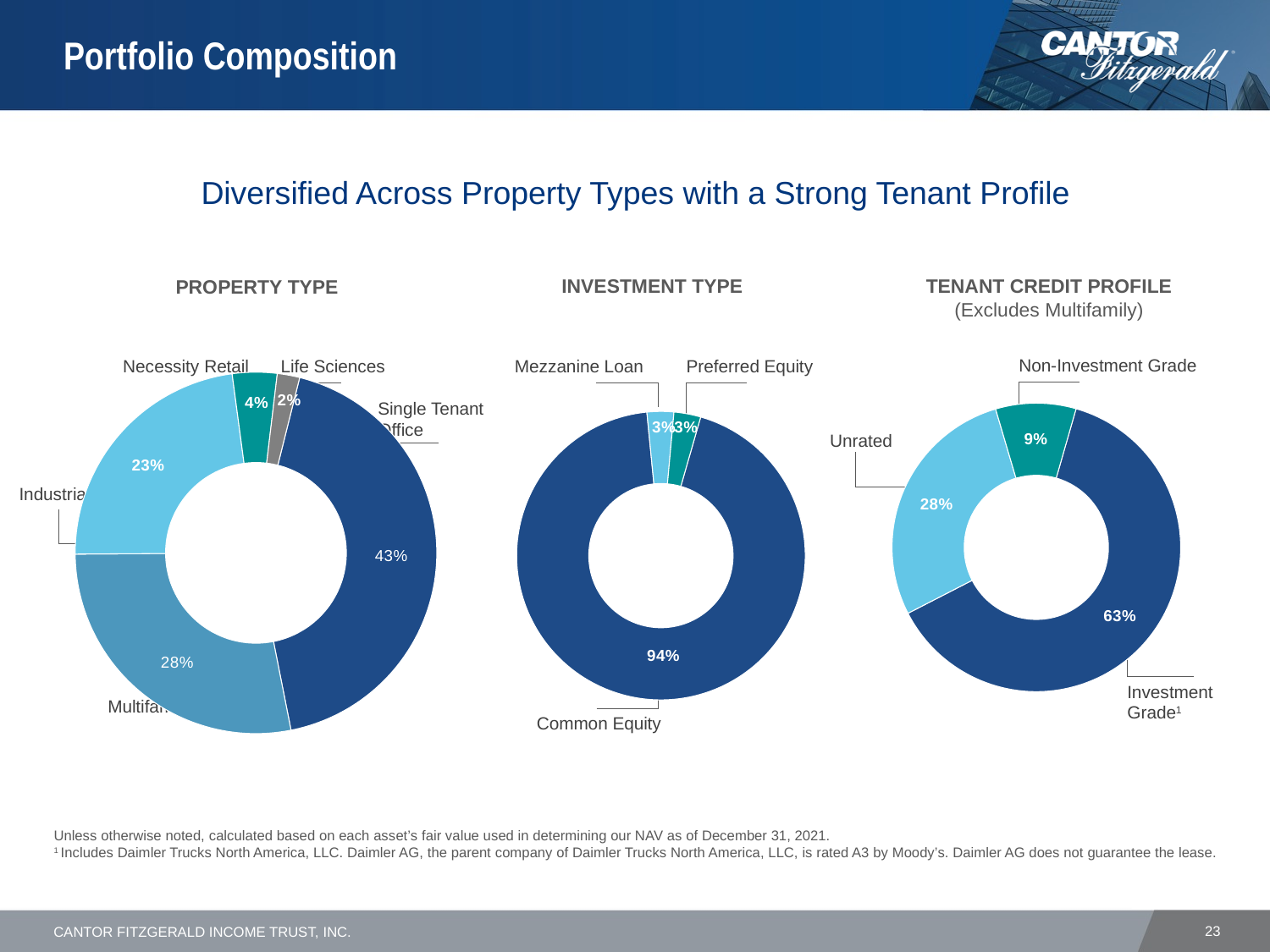
In the Property Type chart, what share is Single Tenant Office? 43% In the Investment Type chart, what share is Mezzanine Loan? 3% In the Tenant Credit Profile chart, which category has the largest share? Investment Grade In the Tenant Credit Profile chart, what is the difference between the Investment Grade share and the Non-Investment Grade share? 54% In the Investment Type chart, how many investment types are shown? 3 In the Property Type chart, how many property types are shown? 5 In the Investment Type chart, what share is Common Equity? 94% In the Property Type chart, what share is Industrial? 23% In the Property Type chart, what is the difference between the Multifamily share and the Necessity Retail share? 24% What kind of chart is used for the Investment Type chart? Donut (pie) chart In the Property Type chart, which property type has the smallest share? Life Sciences In the Tenant Credit Profile chart, what share is Unrated? 28%